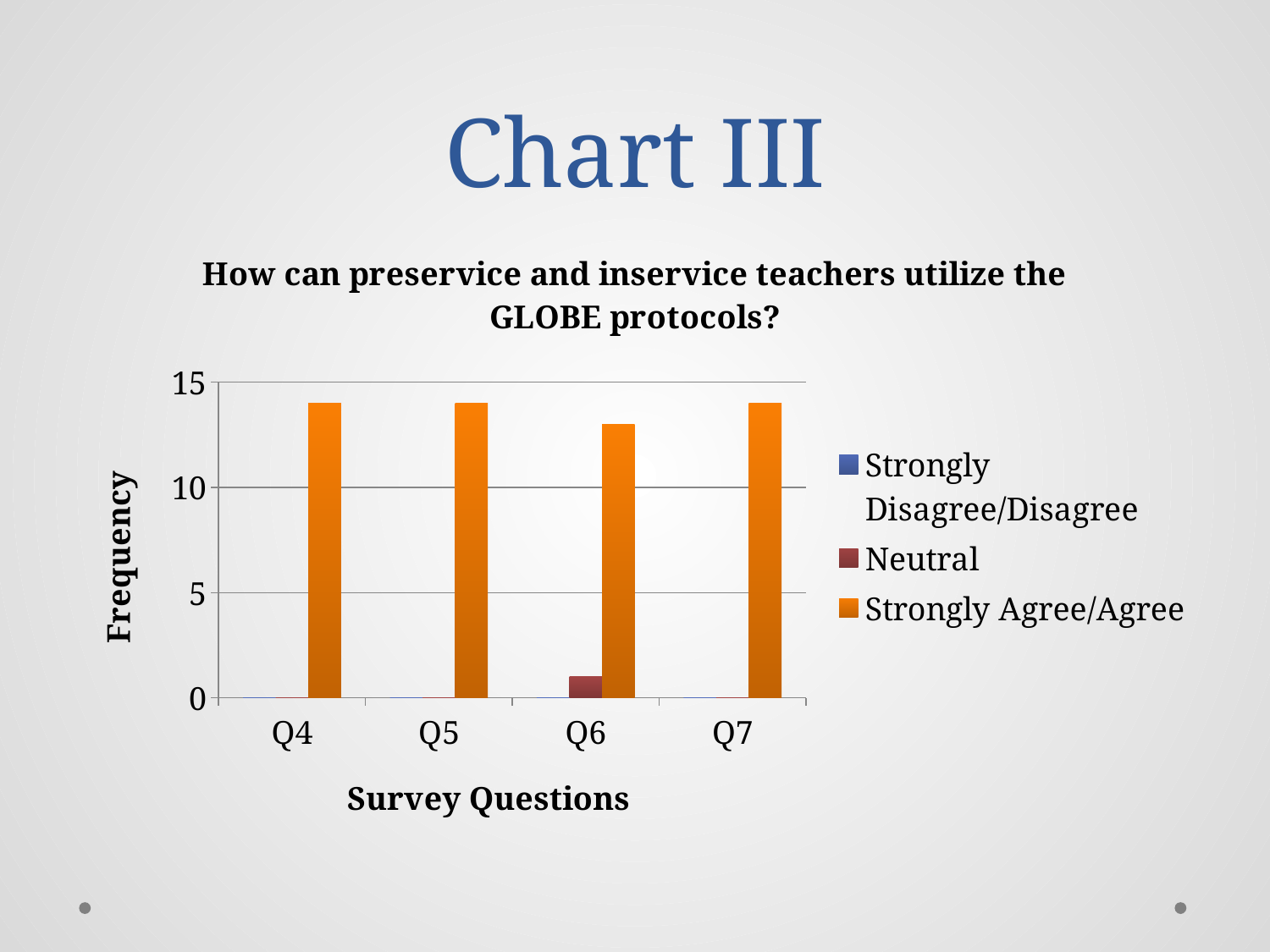
What is the label of the x axis? Survey Questions Is the Strongly Agree/Agree value for Q6 greater or less than 10? greater How many series does the legend list? 3 How many survey questions (categories) are shown on the x axis? 4 Is the Neutral value for Q6 greater or less than 5? less Which is larger, the Strongly Agree/Agree value for Q6 or for Q7? Q7 Which survey question has the highest Neutral value? Q6 Which survey question has the lowest Strongly Agree/Agree value? Q6 Is the Strongly Agree/Agree value for Q4 greater or less than 10? greater What is the label of the y axis? Frequency What kind of chart is shown on the slide? bar chart